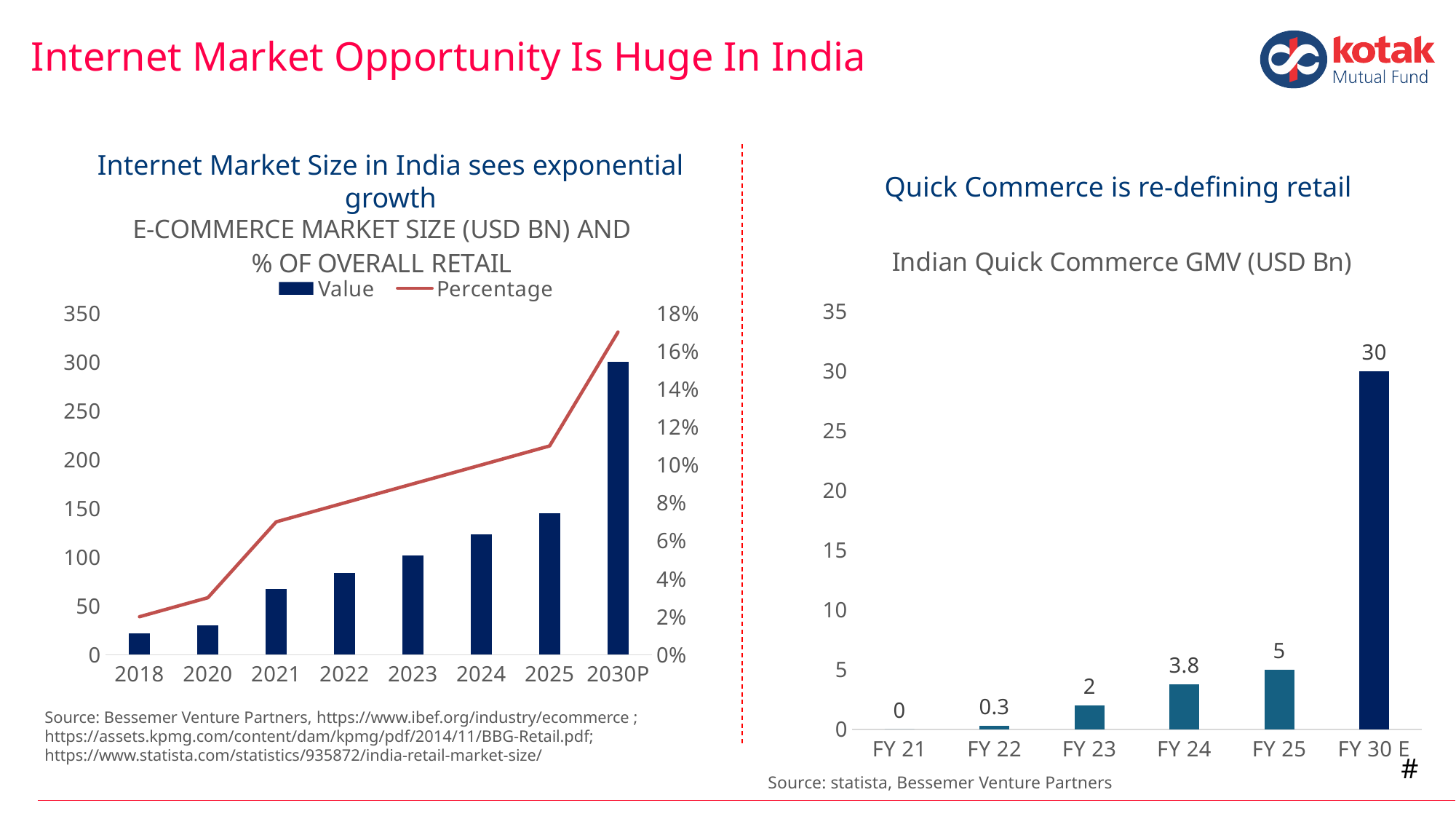
In the 'Indian Quick Commerce GMV (USD Bn)' chart, which fiscal year has the lowest value? FY 21 In the 'Indian Quick Commerce GMV (USD Bn)' chart, what is the value for FY 22? 0.3 In the 'E-COMMERCE MARKET SIZE (USD BN) AND % OF OVERALL RETAIL' chart, which year has the highest Value bar? 2030P In the 'Indian Quick Commerce GMV (USD Bn)' chart, how many fiscal years are shown on the x axis? 6 In the 'Indian Quick Commerce GMV (USD Bn)' chart, what is the value for FY 24? 3.8 In the 'E-COMMERCE MARKET SIZE (USD BN) AND % OF OVERALL RETAIL' chart, how many series does the legend list? 2 In the 'Indian Quick Commerce GMV (USD Bn)' chart, what is the difference between the FY 30 E and FY 25 values? 25 In the 'E-COMMERCE MARKET SIZE (USD BN) AND % OF OVERALL RETAIL' chart, is the Value bar for 2018 greater or less than 50? less In the 'Indian Quick Commerce GMV (USD Bn)' chart, which is larger, the value for FY 23 or FY 25? FY 25 In the 'E-COMMERCE MARKET SIZE (USD BN) AND % OF OVERALL RETAIL' chart, is the Value bar for 2025 greater or less than 100? greater In the 'Indian Quick Commerce GMV (USD Bn)' chart, what is the value for FY 30 E? 30 In the 'E-COMMERCE MARKET SIZE (USD BN) AND % OF OVERALL RETAIL' chart, do the Value bars rise or fall from 2018 to 2030P? rise